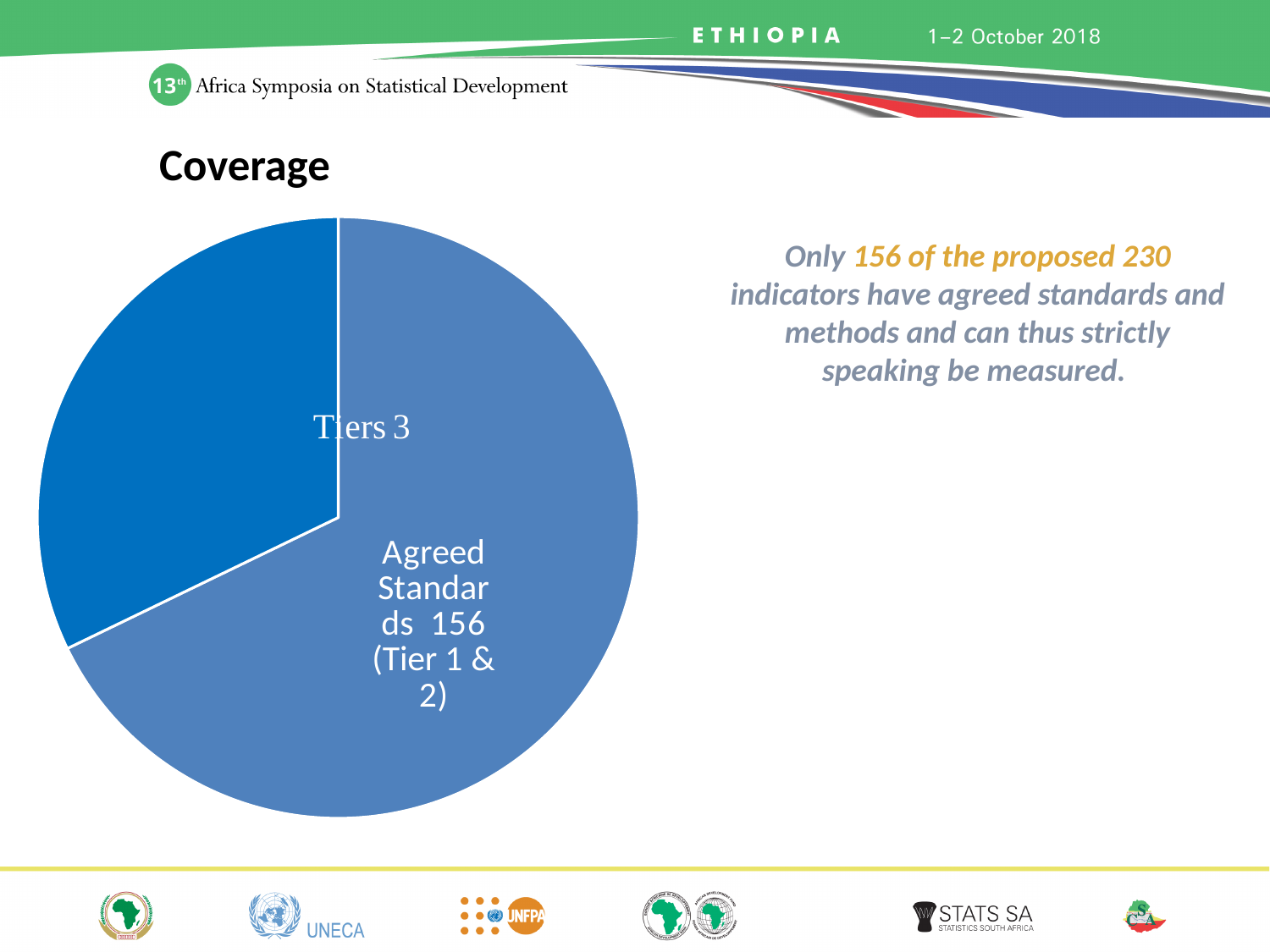
Which slice of the pie chart is the smallest? Tiers 3 What value is printed for the Agreed Standards (Tier 1 & 2) slice? 156 What kind of chart is shown on the slide? pie chart Which tier is represented by the darker blue slice? Tiers 3 What is the title of the chart on the slide? Coverage Which slice is larger, Tiers 3 or Agreed Standards (Tier 1 & 2)? Agreed Standards (Tier 1 & 2) Is the Agreed Standards (Tier 1 & 2) slice more or less than half of the pie? more How many slices does the pie chart have? 2 Which slice of the pie chart is the largest? Agreed Standards 156 (Tier 1 & 2)